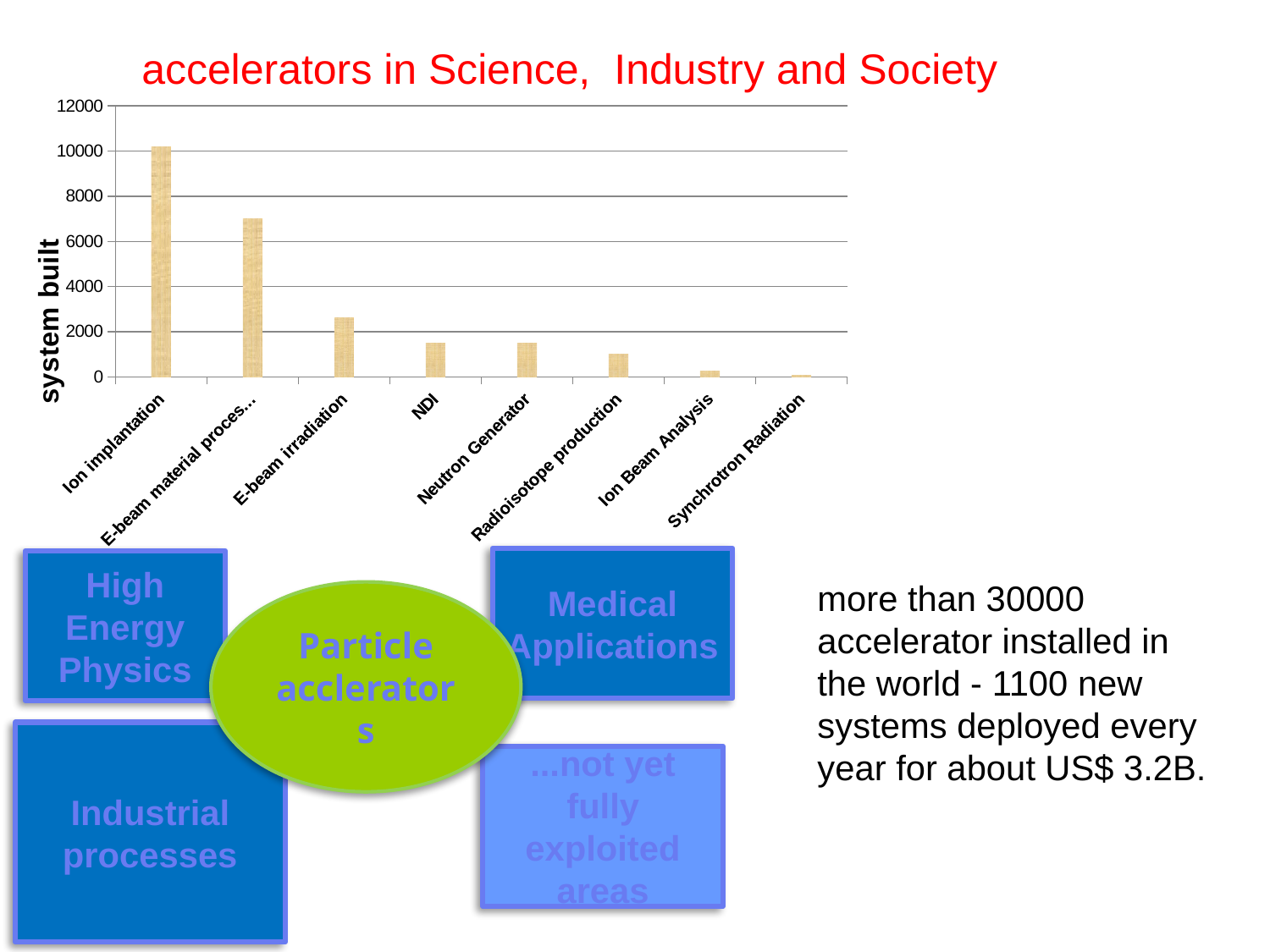
How many categories are plotted on the x axis of the chart? 8 Do the values generally rise or fall from left to right along the x axis? fall Which category has the highest number of systems built? Ion implantation What is the title of the vertical axis of the chart? system built Is the value for Ion implantation greater or less than 10000? greater Is the value for Ion Beam Analysis greater or less than 2000? less Is the value for E-beam material proces... greater or less than 6000? greater Which category has the lowest number of systems built? Synchrotron Radiation What kind of chart is shown on the slide? bar chart Which is larger, the value for Ion Beam Analysis or the value for NDI? NDI Which is larger, the value for E-beam irradiation or the value for Radioisotope production? E-beam irradiation